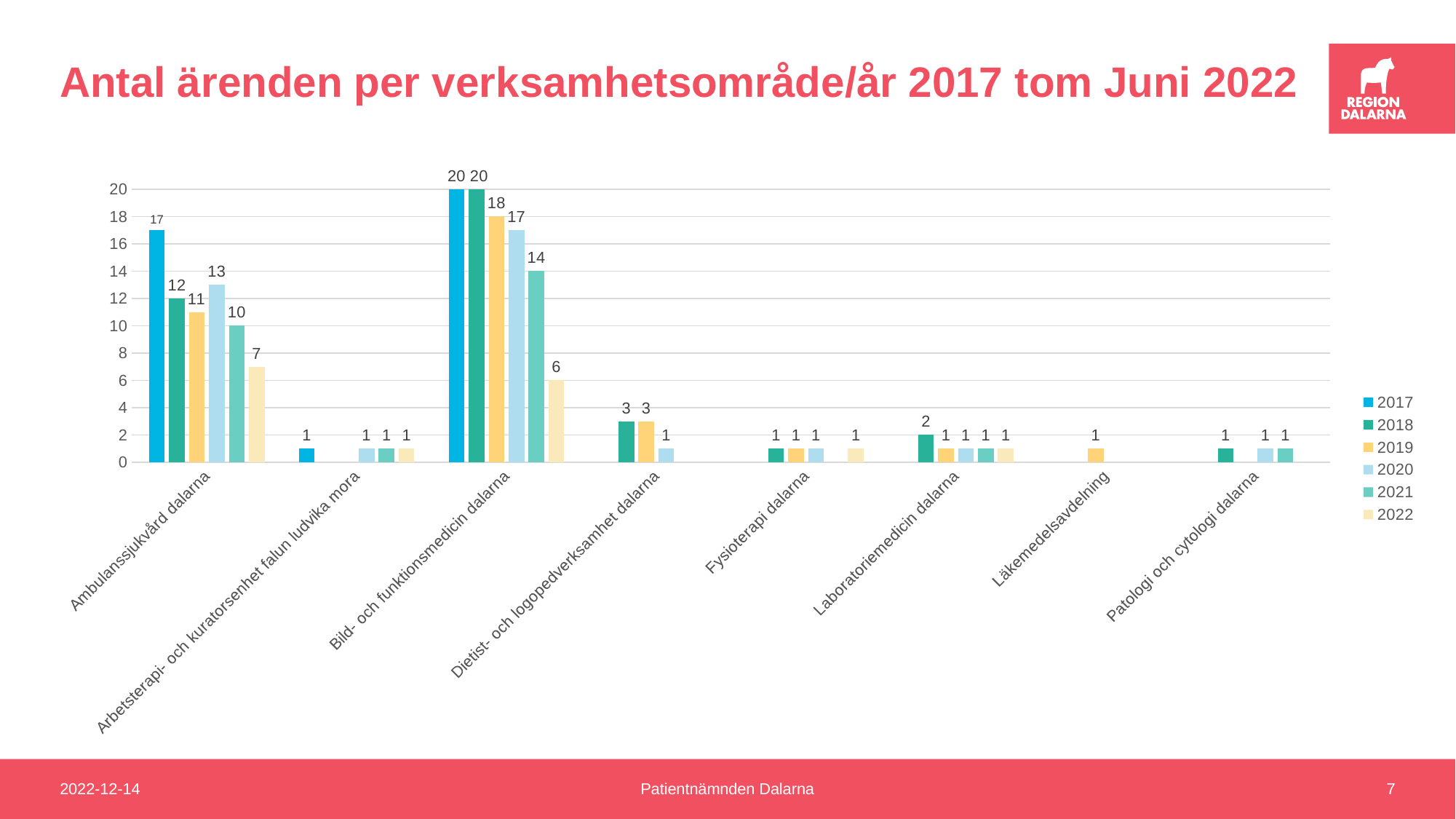
What is the value for 2018 in the Laboratoriemedicin dalarna category? 2 What is the title of the chart on the slide? Antal ärenden per verksamhetsområde/år 2017 tom Juni 2022 What is the value for 2022 in the Bild- och funktionsmedicin dalarna category? 6 What is the value for 2017 in the Ambulanssjukvård dalarna category? 17 Which is larger for Ambulanssjukvård dalarna: the 2020 value or the 2021 value? 2020 Which category has the highest value for the 2019 series? Bild- och funktionsmedicin dalarna How many categories are shown on the x axis? 8 What is the difference between the 2017 and 2022 values for Bild- och funktionsmedicin dalarna? 14 Within the Ambulanssjukvård dalarna category, which year has the lowest value? 2022 What kind of chart is shown on the slide? Bar chart Do the values for Bild- och funktionsmedicin dalarna rise or fall from 2019 to 2022? Fall How many series does the legend list? 6